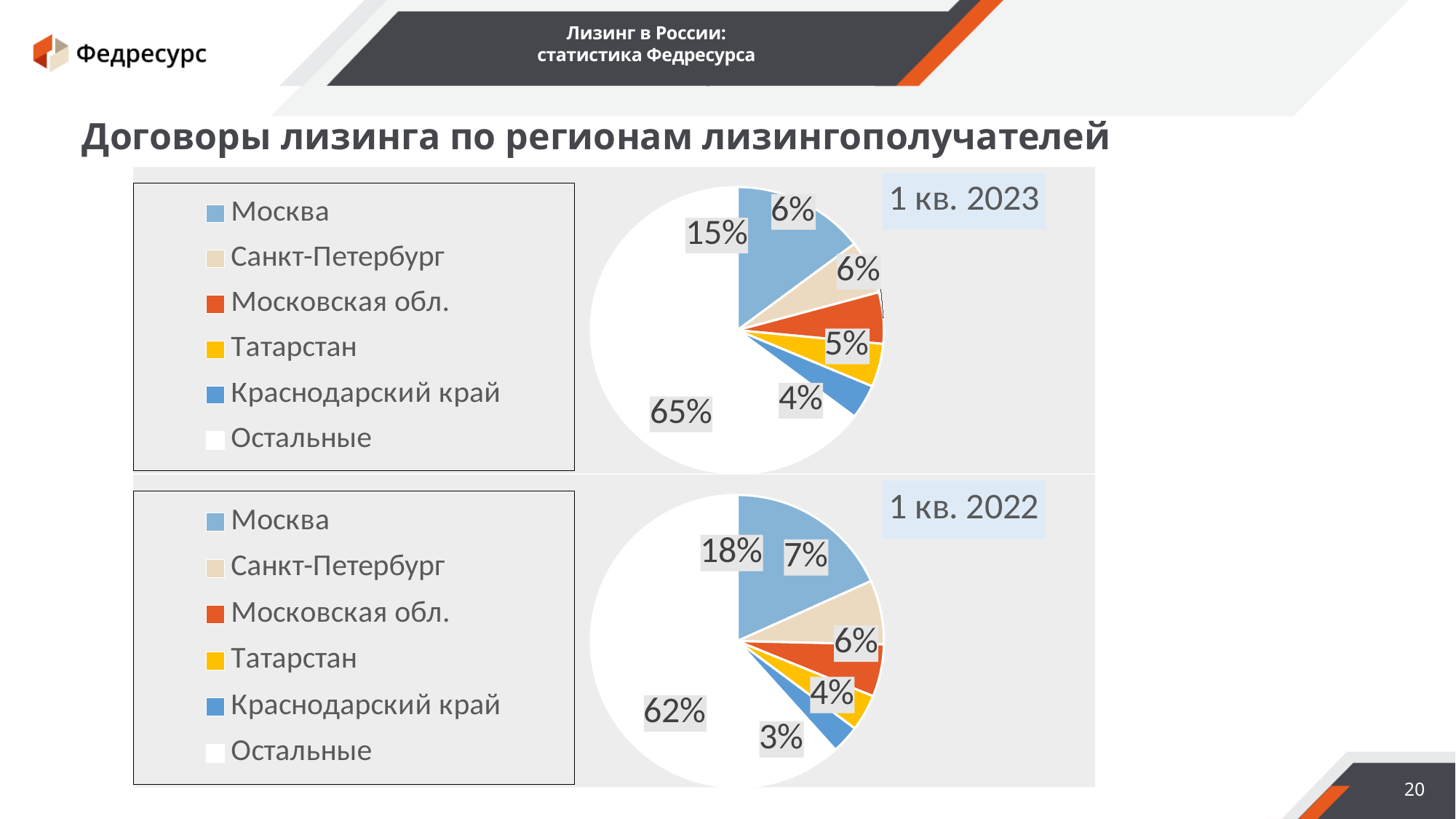
In the 1 кв. 2023 pie chart, what share does Остальные have? 65% By how many percentage points does the share of Москва differ between the 1 кв. 2022 and 1 кв. 2023 pie charts? 3 percentage points In the 1 кв. 2022 pie chart, what share does Остальные have? 62% What is the title of the slide above the two pie charts? Договоры лизинга по регионам лизингополучателей In the 1 кв. 2022 pie chart, what share does Москва have? 18% In the 1 кв. 2023 pie chart, what share does Москва have? 15% How many categories does the legend of the 1 кв. 2023 pie chart list? 6 In the 1 кв. 2022 pie chart, what share does Краснодарский край have? 3% What kind of chart is used on this slide for the 1 кв. 2023 data? Pie chart In the 1 кв. 2022 pie chart, which named region (excluding Остальные) has the smallest share? Краснодарский край In the 1 кв. 2022 pie chart, what share does Санкт-Петербург have? 7% Is the share of Москва larger in the 1 кв. 2022 pie chart or in the 1 кв. 2023 pie chart? 1 кв. 2022